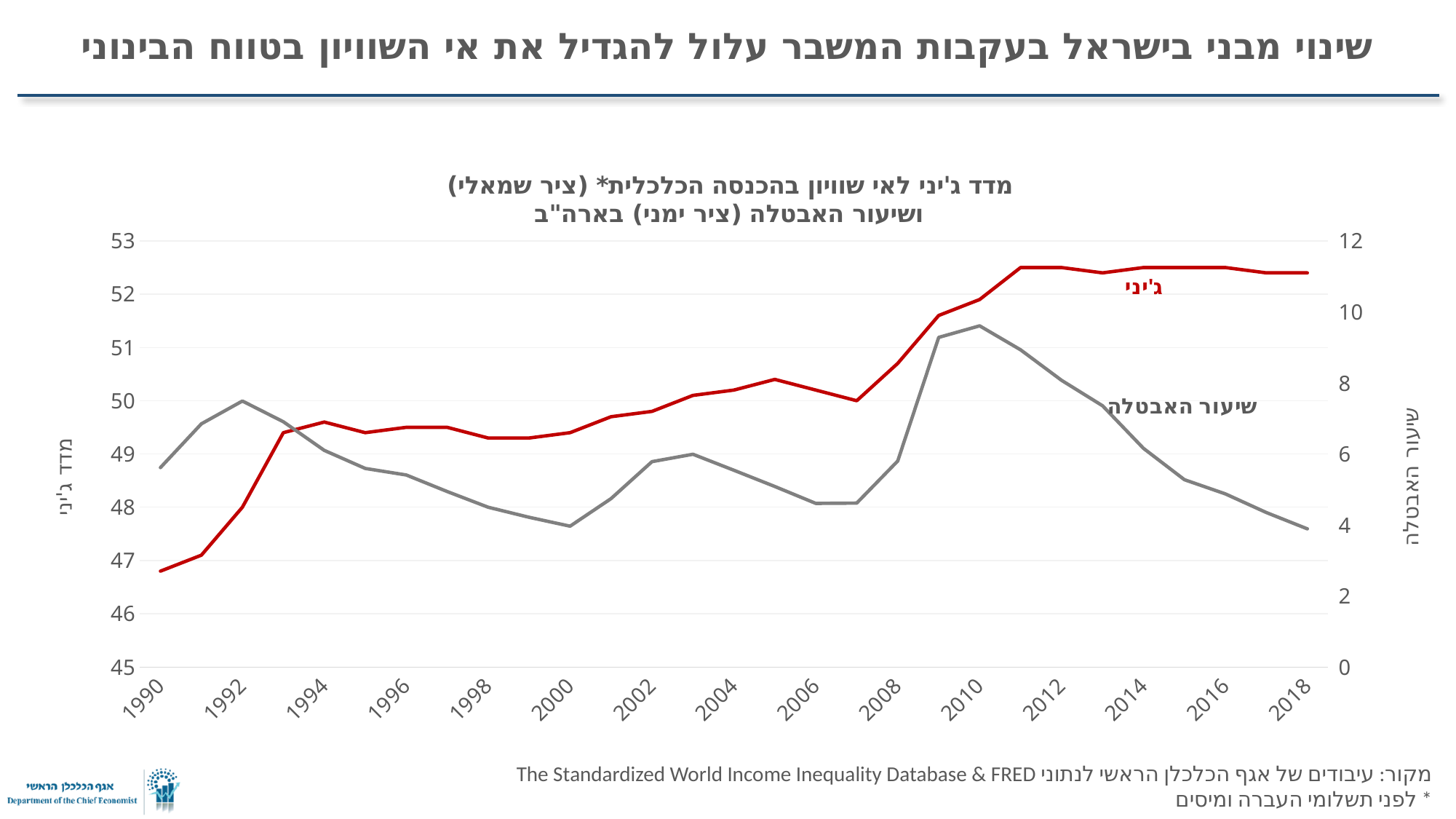
Is the value of the שיעור האבטלה series in 2010 greater or less than 9 on the right axis? greater What is the label of the right-hand vertical axis? שיעור האבטלה Is the value of the ג'יני series in 1990 greater or less than 47 on the left axis? less What kind of chart is shown on the slide? line chart Which series is drawn in red? ג'יני In which year is the ג'יני series at its lowest value? 1990 Does the ג'יני series rise or fall overall from 1990 to 2018? rise Which year has the higher value for the שיעור האבטלה series, 2000 or 2010? 2010 Is the value of the שיעור האבטלה series in 2000 greater or less than 5 on the right axis? less How many series are plotted on the chart? 2 In which year does the שיעור האבטלה series reach its highest value? 2010